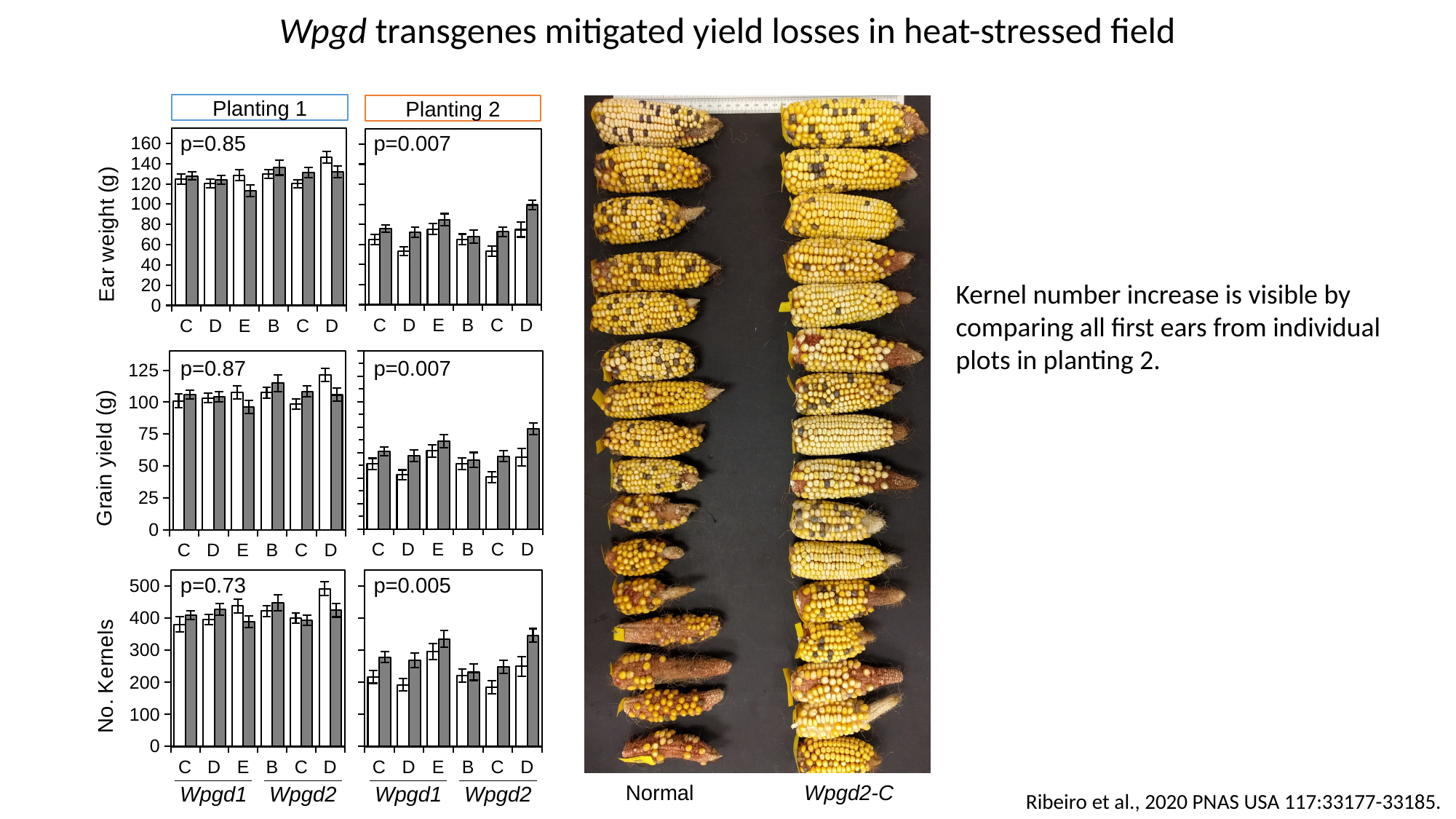
What kind of chart is used in the Planting 1 Ear weight panel? bar chart In the Planting 1 Grain yield chart, is the gray bar for the Wpgd2 B group greater or less than 100? greater In the Planting 2 Ear weight chart, is the gray bar for the Wpgd2 D group greater or less than 80? greater In the Planting 2 Ear weight chart, which group has the tallest gray bar? D (Wpgd2) In the Planting 1 Ear weight chart, is the white bar for the Wpgd2 D group greater or less than 120? greater What p-value is printed in the Planting 2 Ear weight chart? p=0.007 In the Planting 1 Ear weight chart, how many labelled groups are on the x axis? 6 What p-value is printed in the Planting 1 No. Kernels chart? p=0.73 In the Planting 2 Ear weight chart, for the Wpgd2 D group, is the white bar or the gray bar taller? gray bar How many bar chart panels are shown on the slide? 6